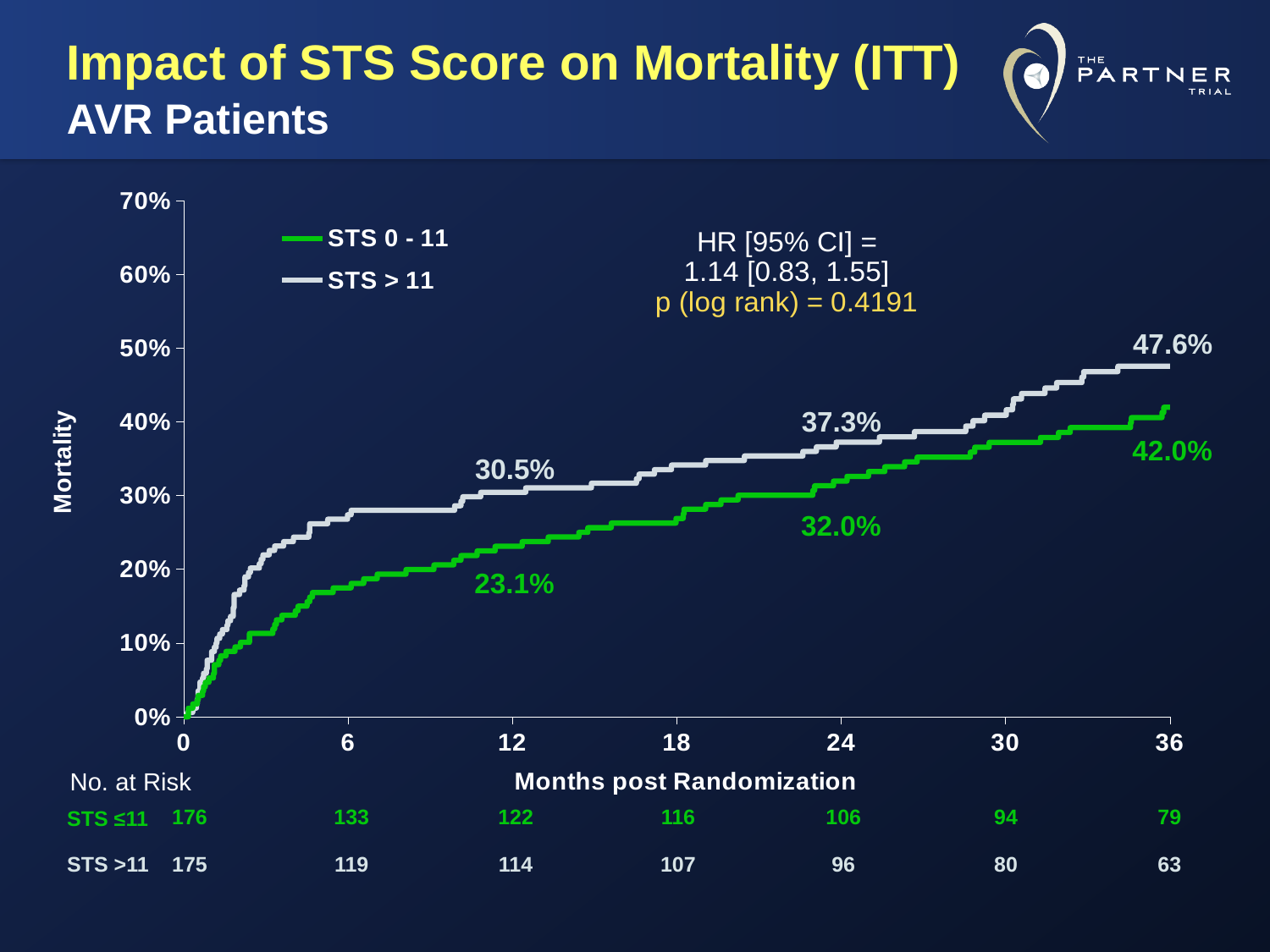
What is the mortality for the STS > 11 group at 12 months? 30.5% How many series does the legend list? 2 What is the mortality for the STS 0 - 11 group at 12 months? 23.1% Which group has the higher mortality at 24 months, STS 0 - 11 or STS > 11? STS > 11 What is the mortality for the STS 0 - 11 group at 36 months? 42.0% Is the mortality for the STS > 11 group at 36 months greater or less than 50%? less What is the difference in mortality between the STS > 11 and STS 0 - 11 groups at 12 months? 7.4% What is the p (log rank) value shown on the chart? 0.4191 What is the difference in mortality between the STS > 11 and STS 0 - 11 groups at 36 months? 5.6% What kind of chart is shown on the slide? Line chart (Kaplan-Meier curve) What is the mortality for the STS > 11 group at 24 months? 37.3% Do the mortality curves rise or fall as months post randomization increase? rise